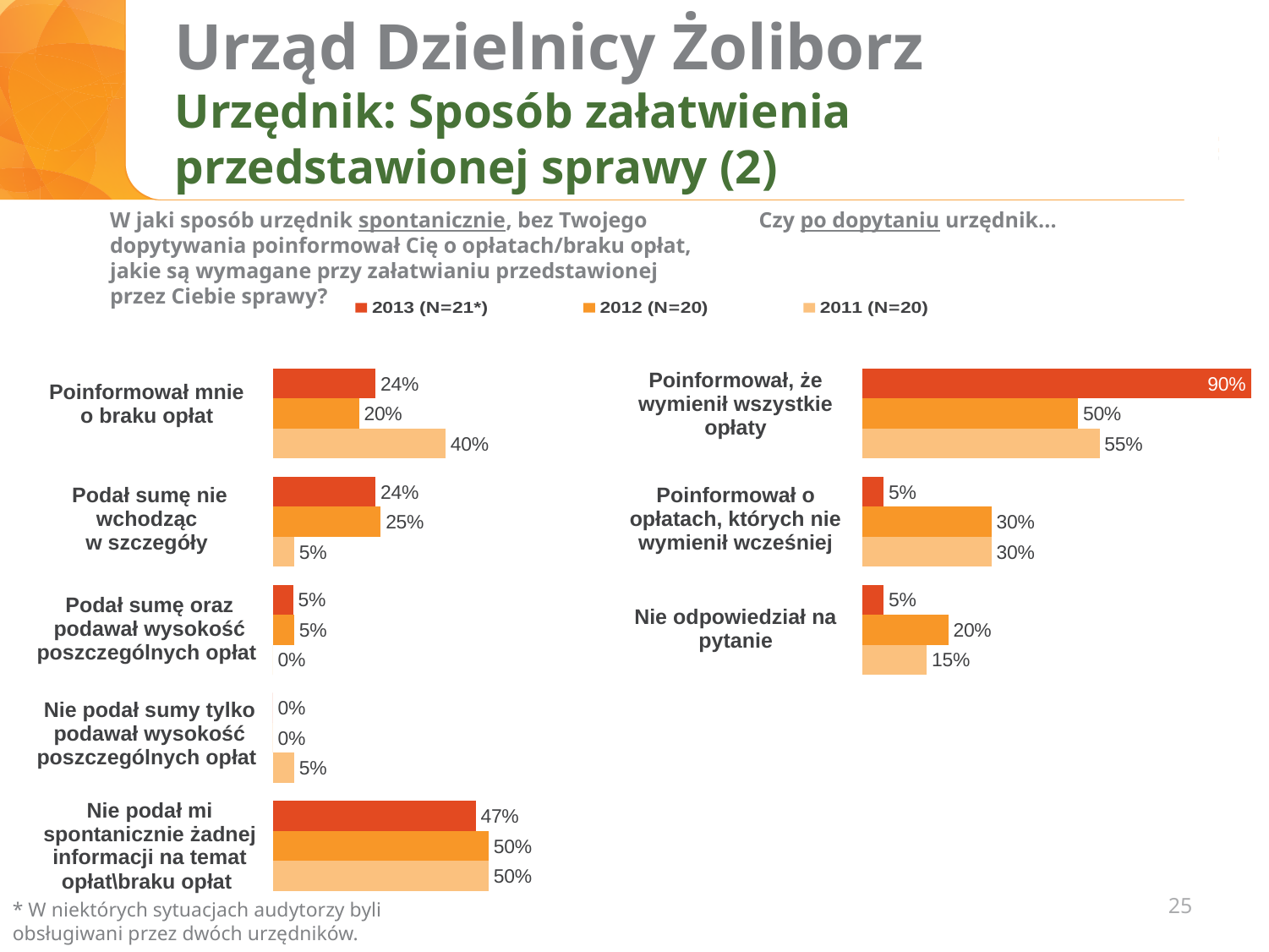
In the right chart, what is the difference between the 2013 and 2012 values for "Poinformował, że wymienił wszystkie opłaty"? 40 percentage points How many series does the legend list? 3 In the left chart, what is the 2011 value for "Poinformował mnie o braku opłat"? 40% Which series is shown in the lightest orange colour in the legend? 2011 (N=20) In the right chart, what is the 2013 value for "Poinformował, że wymienił wszystkie opłaty"? 90% In the right chart, which category has the lowest 2012 value? Nie odpowiedział na pytanie In the left chart, which category has the highest 2013 value? Nie podał mi spontanicznie żadnej informacji na temat opłat\braku opłat How many categories does the left chart show? 5 In the left chart, which is larger for "Podał sumę nie wchodząc w szczegóły": the 2012 value or the 2011 value? 2012 What type of chart is used on this slide? Bar chart In the left chart, what is the 2013 value for "Nie podał mi spontanicznie żadnej informacji na temat opłat\braku opłat"? 47% In the right chart, what is the 2012 value for "Nie odpowiedział na pytanie"? 20%